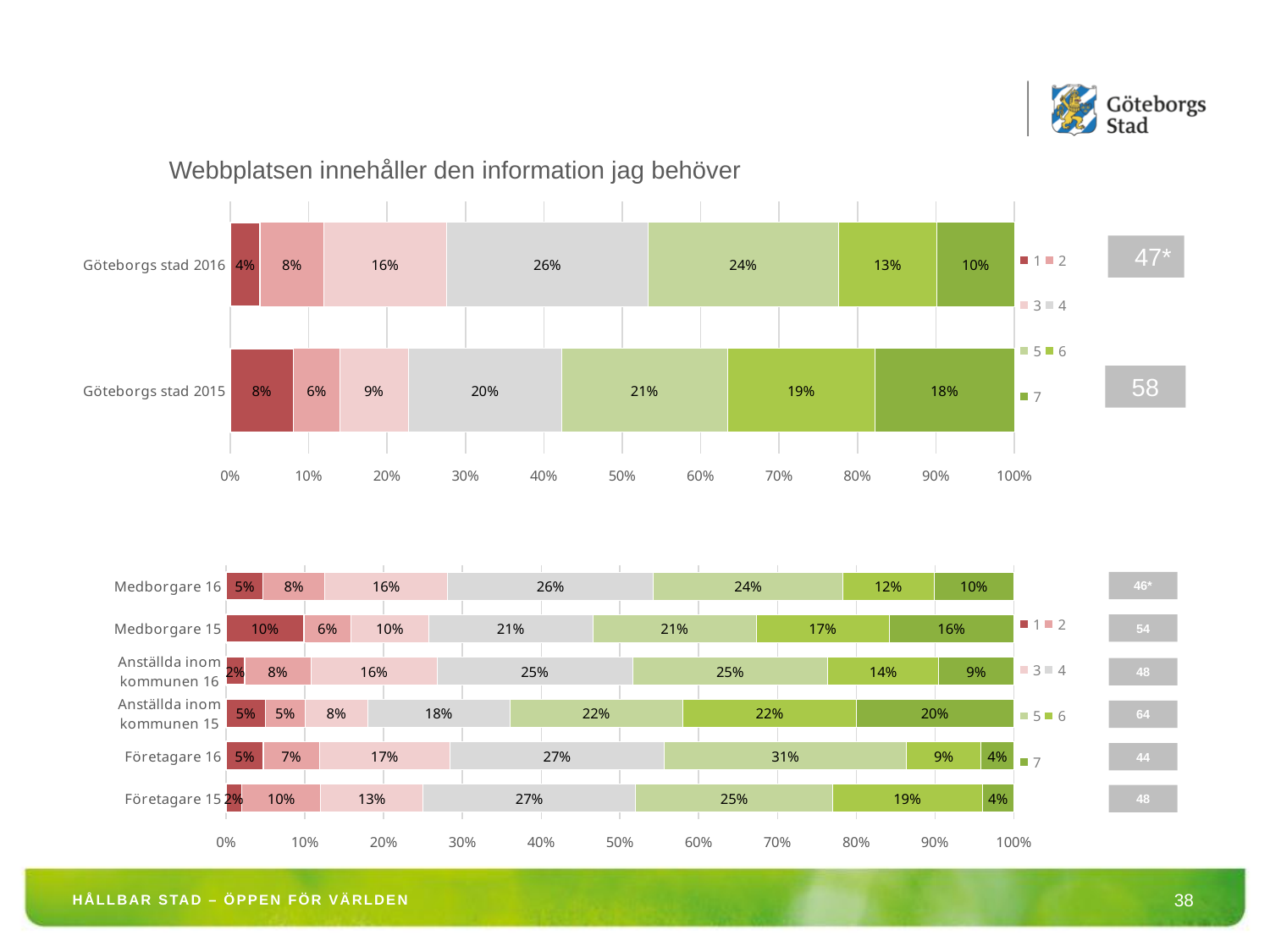
In the bottom chart, which category has the highest value for series 7? Anställda inom kommunen 15 In the top chart, what is the value for series 7 for Göteborgs stad 2015? 18% In the top chart, which has the larger series 6 value, Göteborgs stad 2016 or Göteborgs stad 2015? Göteborgs stad 2015 In the bottom chart, what is the difference between the series 4 values for Medborgare 16 and Medborgare 15? 5 percentage points In the bottom chart, how many categories are shown? 6 In the bottom chart, what is the value for series 5 for Företagare 16? 31% In the top chart, what is the difference between the series 7 values for Göteborgs stad 2015 and Göteborgs stad 2016? 8 percentage points In the top chart, what is the value for series 4 for Göteborgs stad 2016? 26% In the bottom chart, which category has the highest value for series 5? Företagare 16 What is the title of the top chart? Webbplatsen innehåller den information jag behöver What kind of chart is the top chart? Stacked bar chart In the top chart, how many series does the legend list? 7